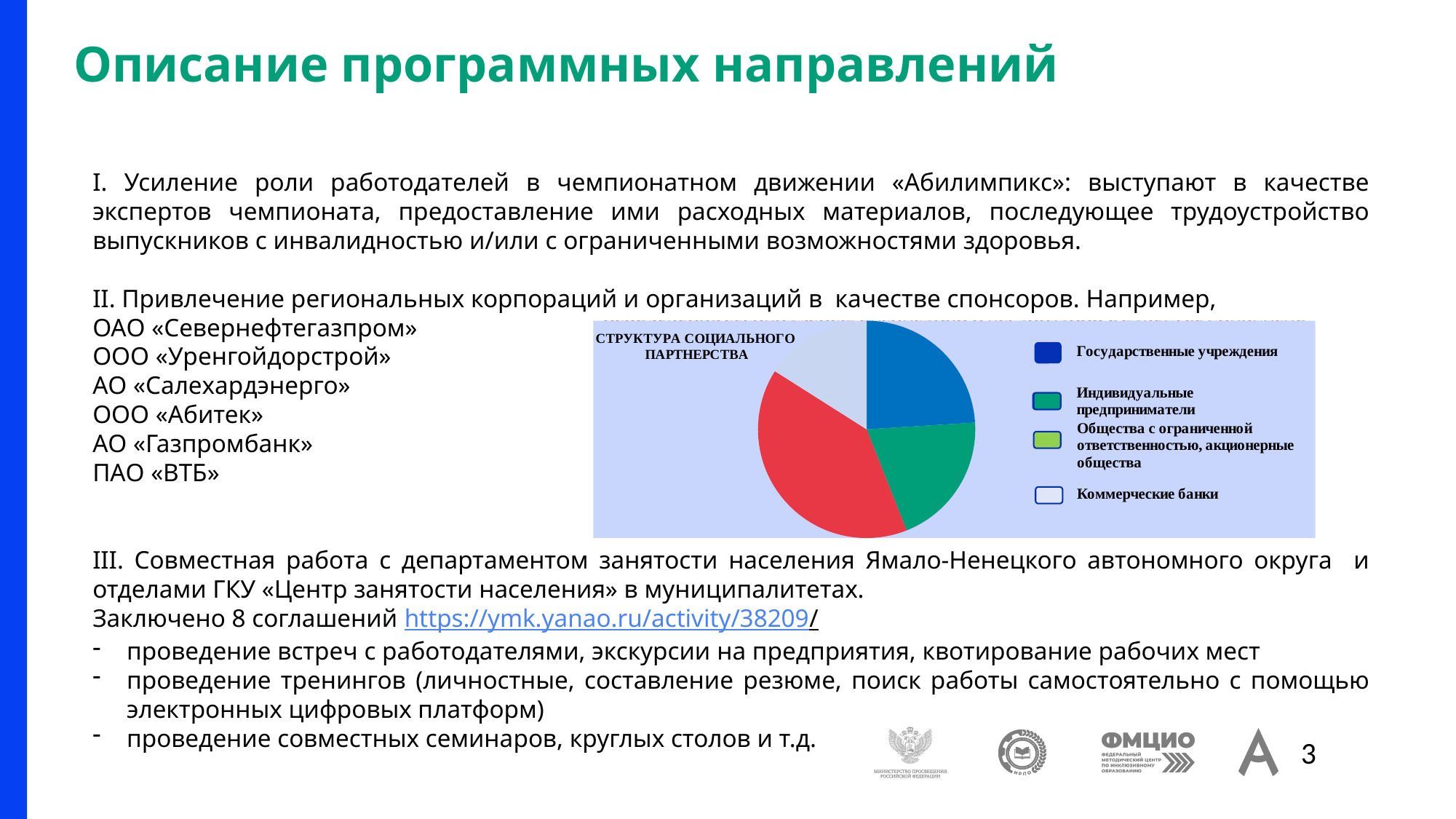
Which is larger in the pie chart: the dark blue slice or the green slice? the dark blue slice Which legend entry is shown with the dark blue colour in the pie chart? Государственные учреждения How many entries does the legend of the pie chart list? 4 Is the dark blue slice of the pie chart greater or less than half of the pie? less What is the title of the pie chart? СТРУКТУРА СОЦИАЛЬНОГО ПАРТНЕРСТВА Which colour slice is the largest in the pie chart? red What kind of chart is shown on the slide? pie chart How many slices does the pie chart have? 4